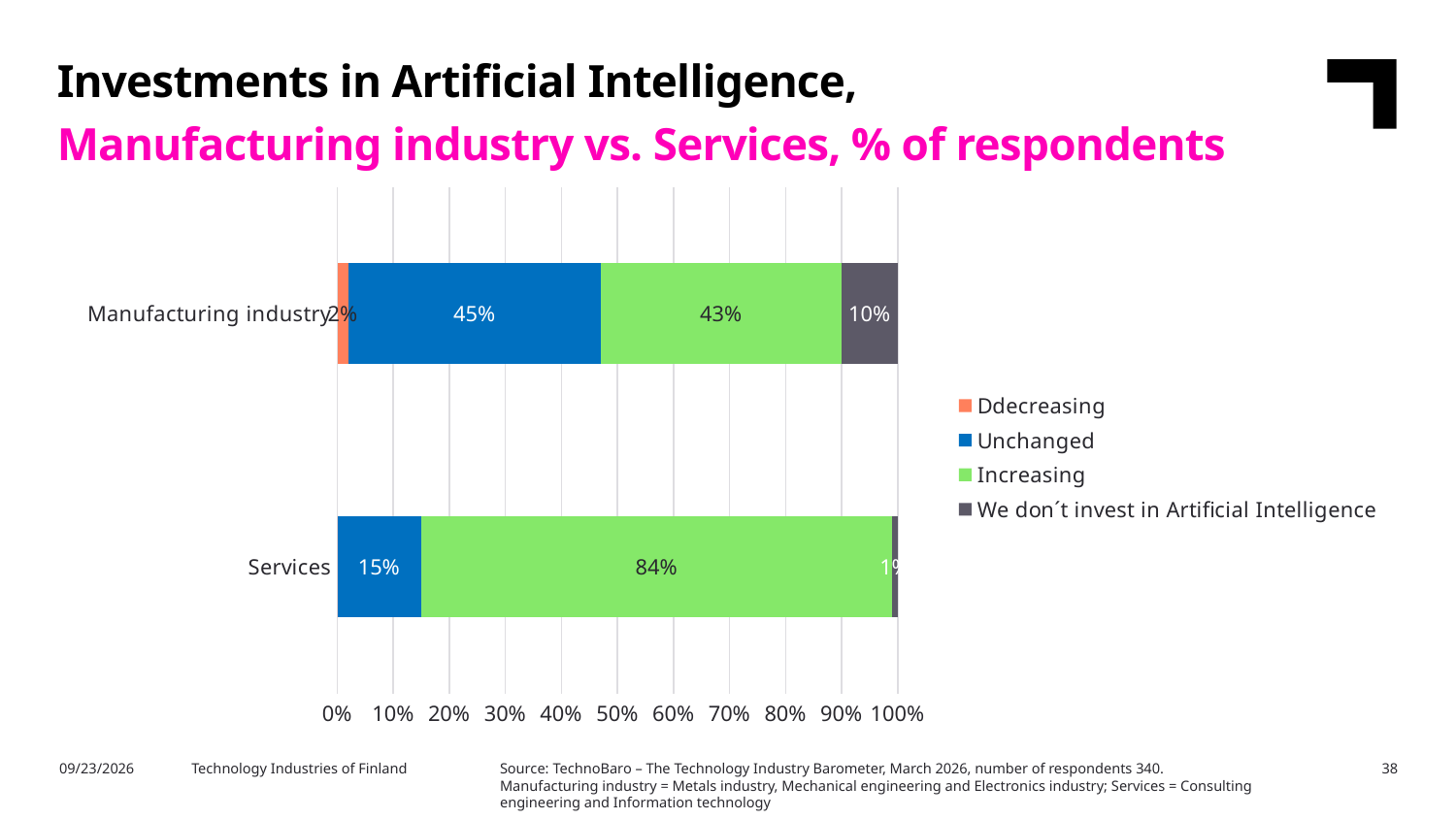
What is the Increasing value for Manufacturing industry? 43% How many series does the legend list? 4 Which legend entry is shown in green? Increasing What is the Increasing value for Services? 84% What is the Ddecreasing value for Manufacturing industry? 2% What is the difference between the Unchanged values for Manufacturing industry and Services? 30% How many categories are plotted on the chart? 2 What is the Unchanged value for Manufacturing industry? 45% What kind of chart is shown on the slide? Stacked bar chart What is the 'We don't invest in Artificial Intelligence' value for Manufacturing industry? 10% What is the Unchanged value for Services? 15% Which category has the higher Increasing value, Manufacturing industry or Services? Services